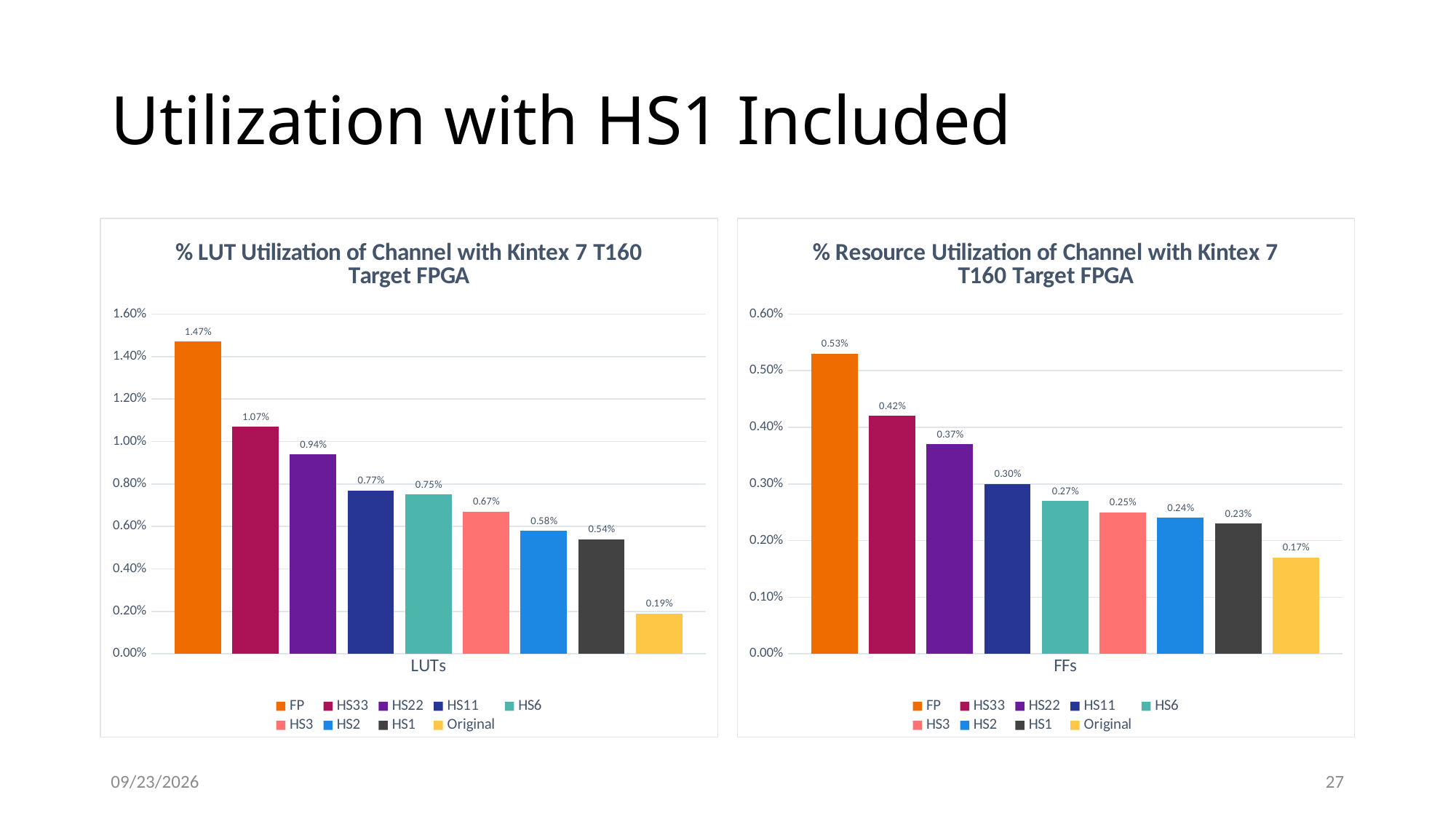
In the right chart (% Resource Utilization, FFs), which series has the lowest value? Original In the left chart (% LUT Utilization), what is the value for HS22? 0.94% In the right chart (% Resource Utilization, FFs), is the value for HS22 greater or less than 0.30%? greater In the right chart (% Resource Utilization, FFs), what is the value for HS6? 0.27% In the left chart (% LUT Utilization), what is the value for HS1? 0.54% How many series does the legend of the left chart list? 9 In the left chart (% LUT Utilization), what is the difference between the FP value and the Original value? 1.28% What kind of chart is the right chart (% Resource Utilization)? Bar chart What is the x-axis category label shown on the right chart? FFs In the right chart (% Resource Utilization, FFs), what is the difference between HS33 and HS1? 0.19% In the left chart (% LUT Utilization), which is larger, HS11 or HS3? HS11 In the left chart (% LUT Utilization), which series has the highest value? FP